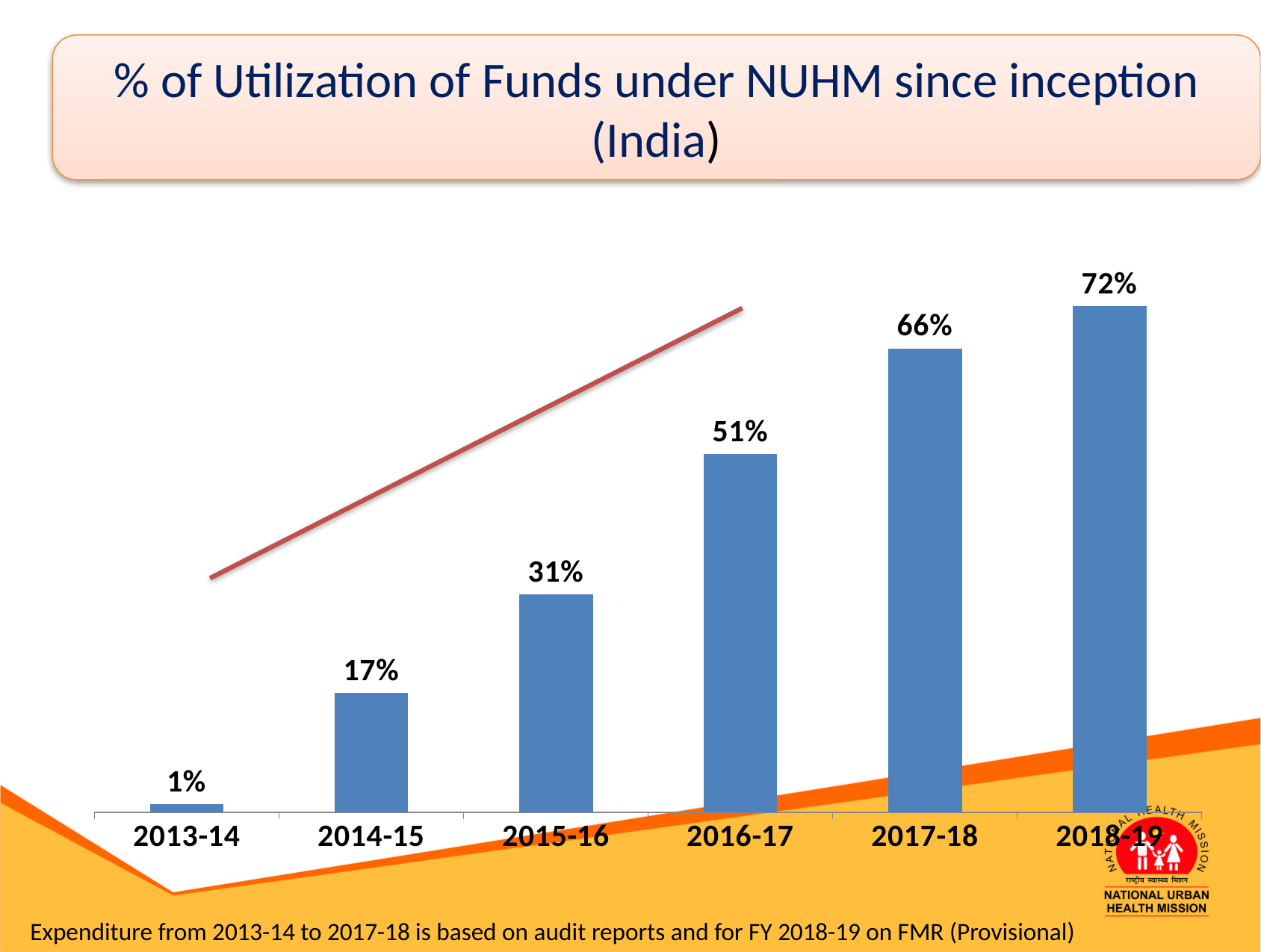
Which year has the highest % of utilization of funds? 2018-19 What is the difference in utilization between 2015-16 and 2014-15? 14% Which year has the lowest % of utilization of funds? 2013-14 What kind of chart is shown on the slide? Bar chart What is the % of utilization of funds for 2018-19? 72% What is the % of utilization of funds for 2016-17? 51% Which year has a higher % of utilization, 2014-15 or 2015-16? 2015-16 What is the % of utilization of funds for 2013-14? 1% How many years are shown on the chart? 6 Does the % of utilization of funds rise or fall from 2013-14 to 2018-19? Rise What is the title of the slide? % of Utilization of Funds under NUHM since inception (India) What is the difference in utilization between 2017-18 and 2016-17? 15%